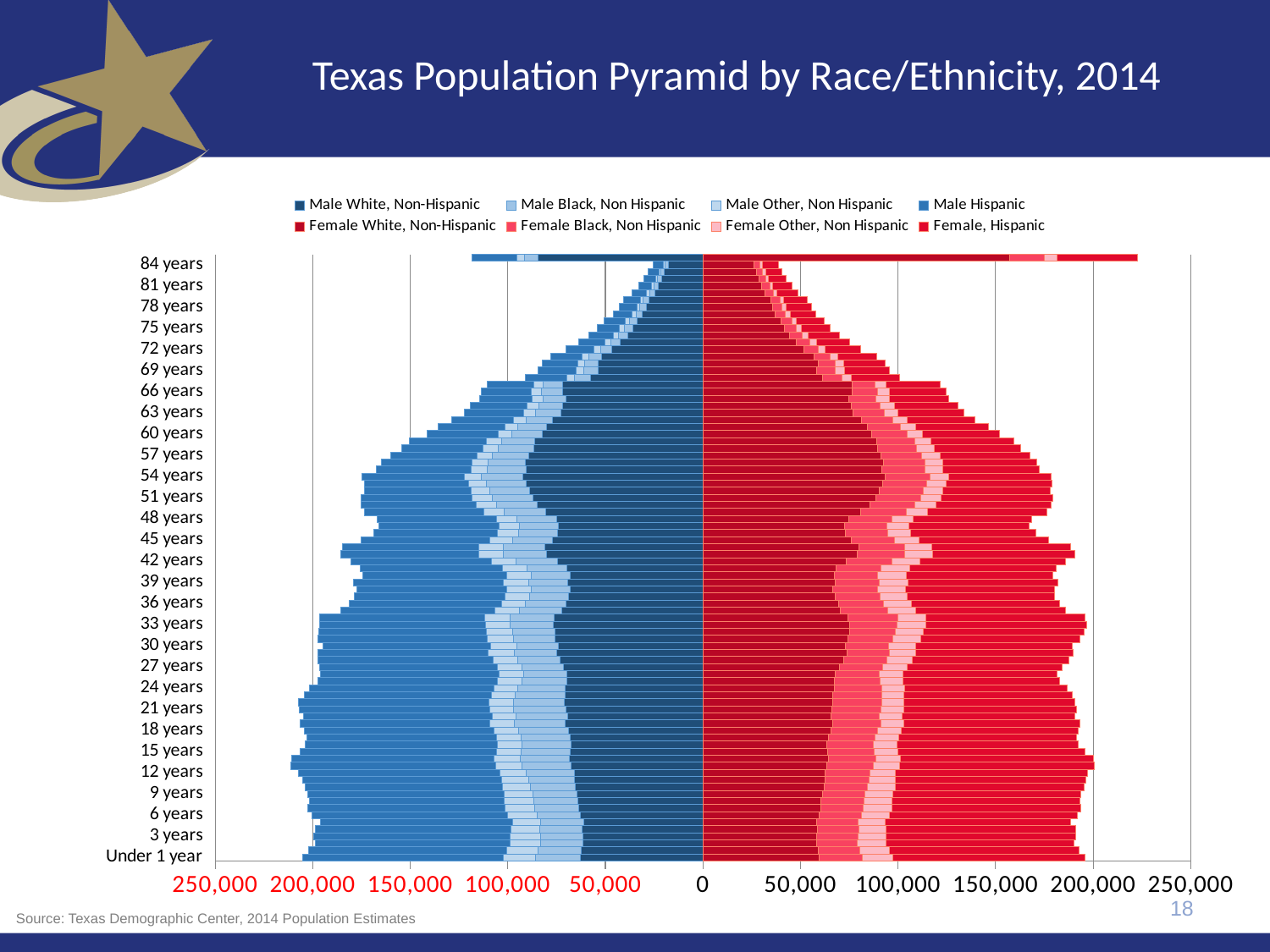
What kind of chart is shown on the slide? Bar chart (population pyramid) Is the total male bar for Under 1 year greater or less than 150,000? greater Is the total male bar for 81 years greater or less than 50,000? less Is the total male bar for 72 years greater or less than 100,000? less What is the title of the chart? Texas Population Pyramid by Race/Ethnicity, 2014 Which is larger, the total male bar for Under 1 year or the total male bar for 81 years? Under 1 year Which colour family is used for the female series in the chart? Red Which is larger, the total female bar for 12 years or the total female bar for 78 years? 12 years How many series does the legend list? 8